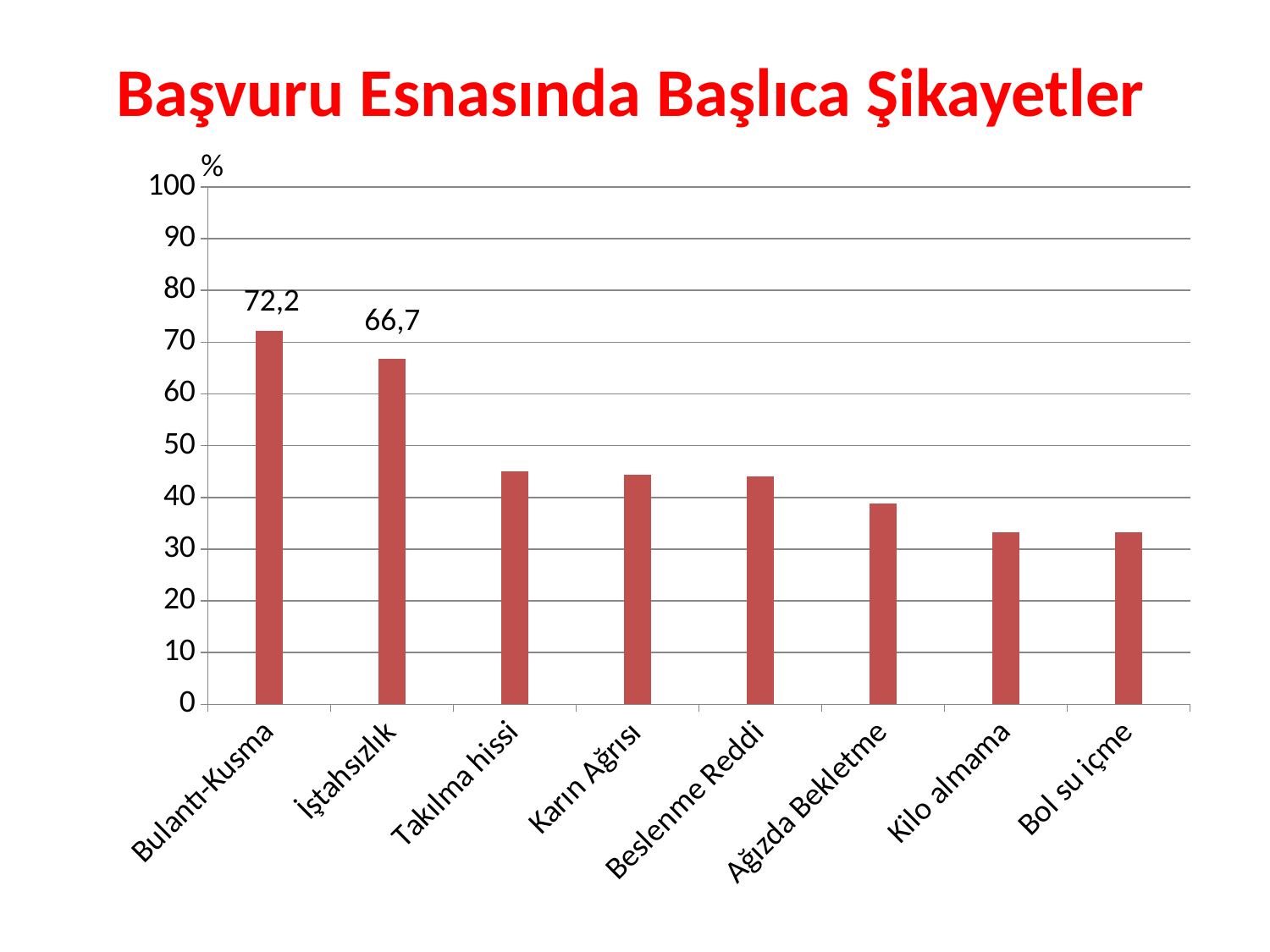
Is the value for Takılma hissi greater or less than 40? greater Is the value for Kilo almama greater or less than 40? less How many categories are shown on the x axis? 8 Is the value for Beslenme Reddi greater or less than 50? less What is the value for İştahsızlık? 66,7 Which category has the highest value? Bulantı-Kusma What is the difference between the values for Bulantı-Kusma and İştahsızlık? 5,5 What kind of chart is shown on the slide? bar chart What is the value for Bulantı-Kusma? 72,2 Do the values generally rise or fall from left to right along the x axis? fall Which is larger, the value for Bulantı-Kusma or the value for Takılma hissi? Bulantı-Kusma What is the title of the slide? Başvuru Esnasında Başlıca Şikayetler